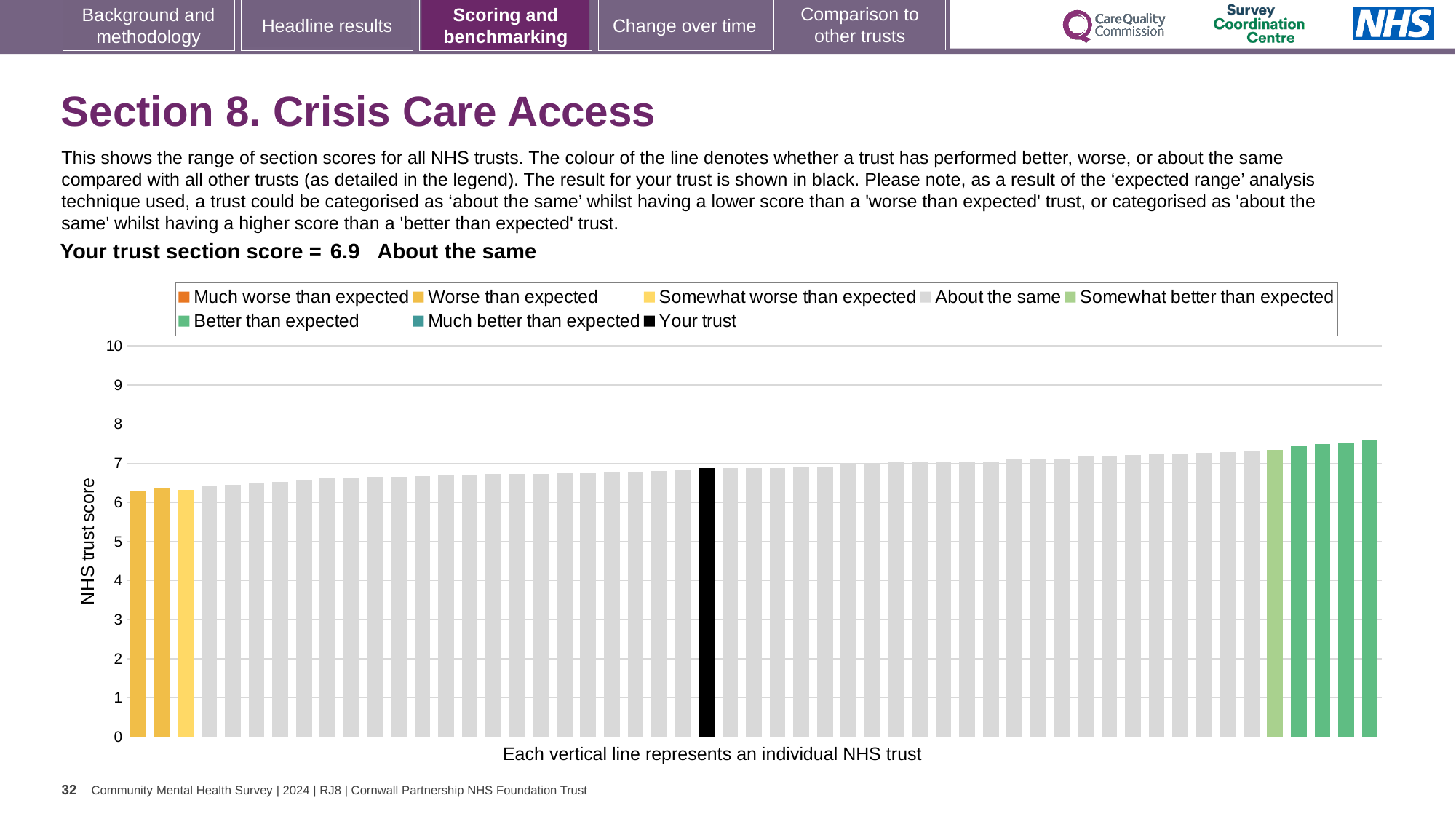
Is the value of the shortest bar in the chart greater or less than 6? greater Is the value of the tallest bar in the chart greater or less than 8? less What is the section score for your trust shown on the slide? 6.9 Do the bar values rise or fall from left to right along the x axis? rise Is the value of the rightmost bar greater or less than 7? greater How many bars are coloured in the 'Worse than expected' yellow colour? 2 What is the label on the vertical axis of the chart? NHS trust score How many entries does the chart legend list? 8 What colour is the bar representing your trust? black What kind of chart is shown on the slide? bar chart How many bars are coloured in the 'Better than expected' green colour? 4